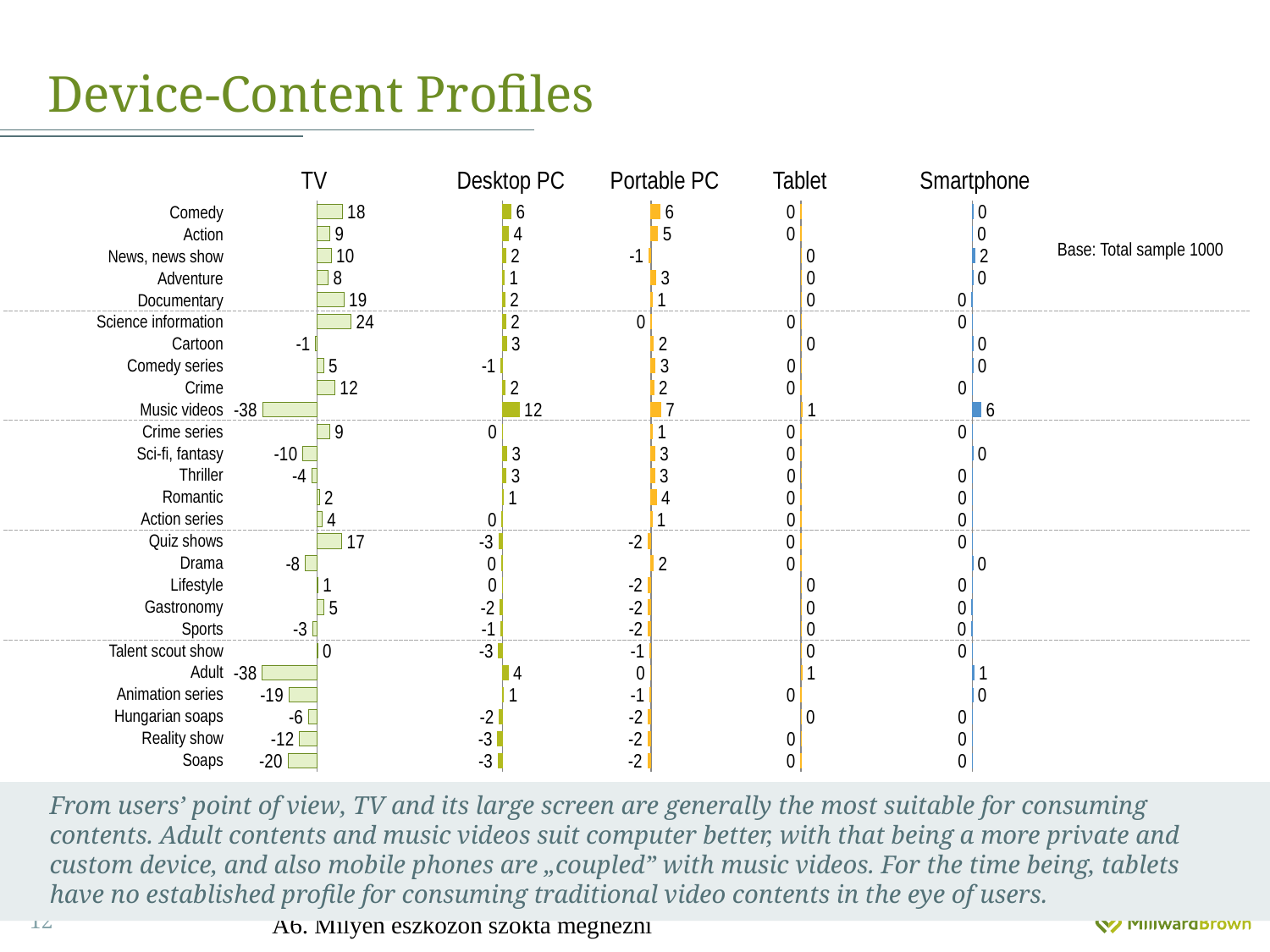
In the TV chart, what is the difference between the values for Documentary and Comedy? 1 In the Desktop PC chart, which category has the lowest value? Quiz shows, Talent scout show, Reality show and Soaps (all -3) In the Desktop PC chart, what is the value for Music videos? 12 What type of chart is used for each device on this slide? Bar chart In the Portable PC chart, what is the value for Romantic? 4 In the Portable PC chart, which category has the highest value? Music videos In the Smartphone chart, what is the value for News, news show? 2 How many content categories are listed in the charts? 26 In the TV chart, what is the value for Science information? 24 How many device charts are shown on the slide? 5 In the TV chart, which category has the highest value? Science information In the TV chart, which is larger, the value for Quiz shows or the value for Crime? Quiz shows